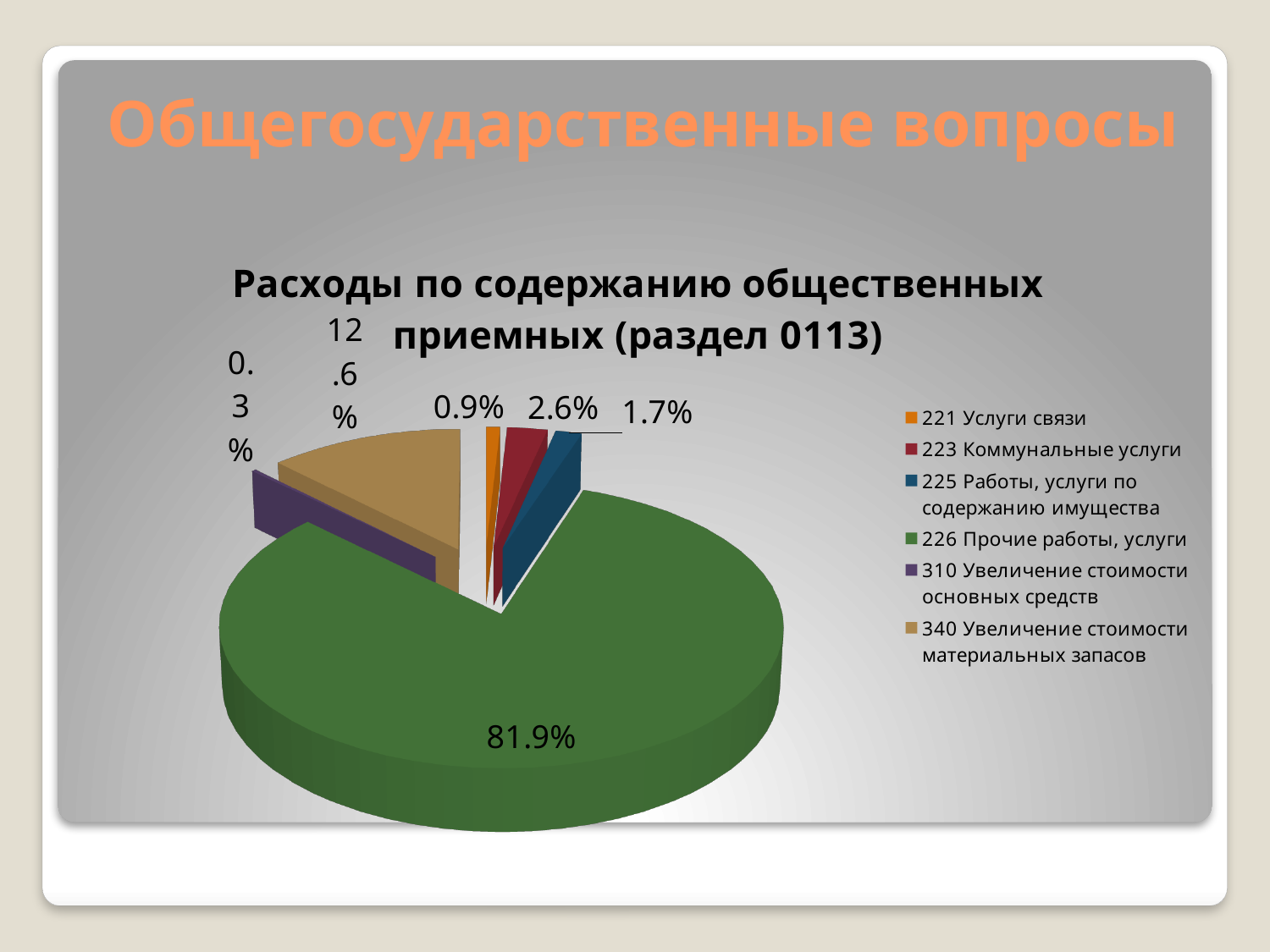
What share of the pie does "226 Прочие работы, услуги" have? 81.9% What kind of chart is shown on the slide? Pie chart What share of the pie does "225 Работы, услуги по содержанию имущества" have? 1.7% Which category has the largest share of the pie? 226 Прочие работы, услуги Which category has the smallest share of the pie? 310 Увеличение стоимости основных средств What share of the pie does "340 Увеличение стоимости материальных запасов" have? 12.6% What share of the pie does "221 Услуги связи" have? 0.9% What is the difference in percentage points between the shares of "226 Прочие работы, услуги" and "340 Увеличение стоимости материальных запасов"? 69.3 Which has a larger share: "223 Коммунальные услуги" or "225 Работы, услуги по содержанию имущества"? 223 Коммунальные услуги How many categories does the legend of the pie chart list? 6 What share of the pie does "223 Коммунальные услуги" have? 2.6% What is the title of the chart? Расходы по содержанию общественных приемных (раздел 0113)